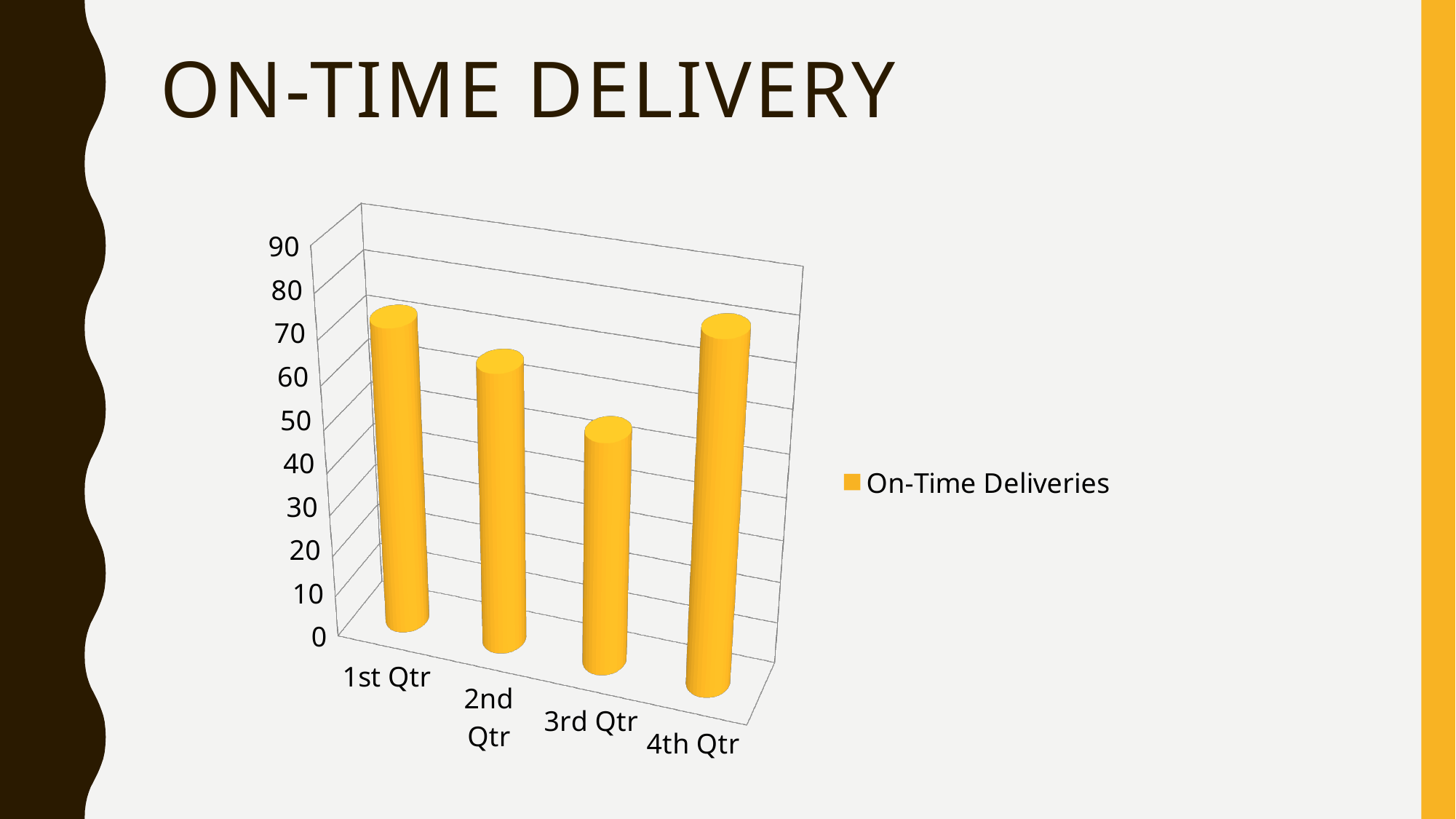
Is the value for 3rd Qtr greater or less than 60? less Which is larger, the value for 2nd Qtr or the value for 3rd Qtr? 2nd Qtr How many series does the legend list? 1 How many quarters are plotted on the chart? 4 What kind of chart is shown on the slide? bar chart What is the title of the slide containing the chart? ON-TIME DELIVERY What is the name of the series shown in the legend? On-Time Deliveries Do the values rise or fall from 1st Qtr to 3rd Qtr? fall Is the value for 4th Qtr greater or less than 60? greater Which quarter has the highest value for On-Time Deliveries? 4th Qtr Which quarter has the lowest value for On-Time Deliveries? 3rd Qtr Is the value for 1st Qtr greater or less than 60? greater